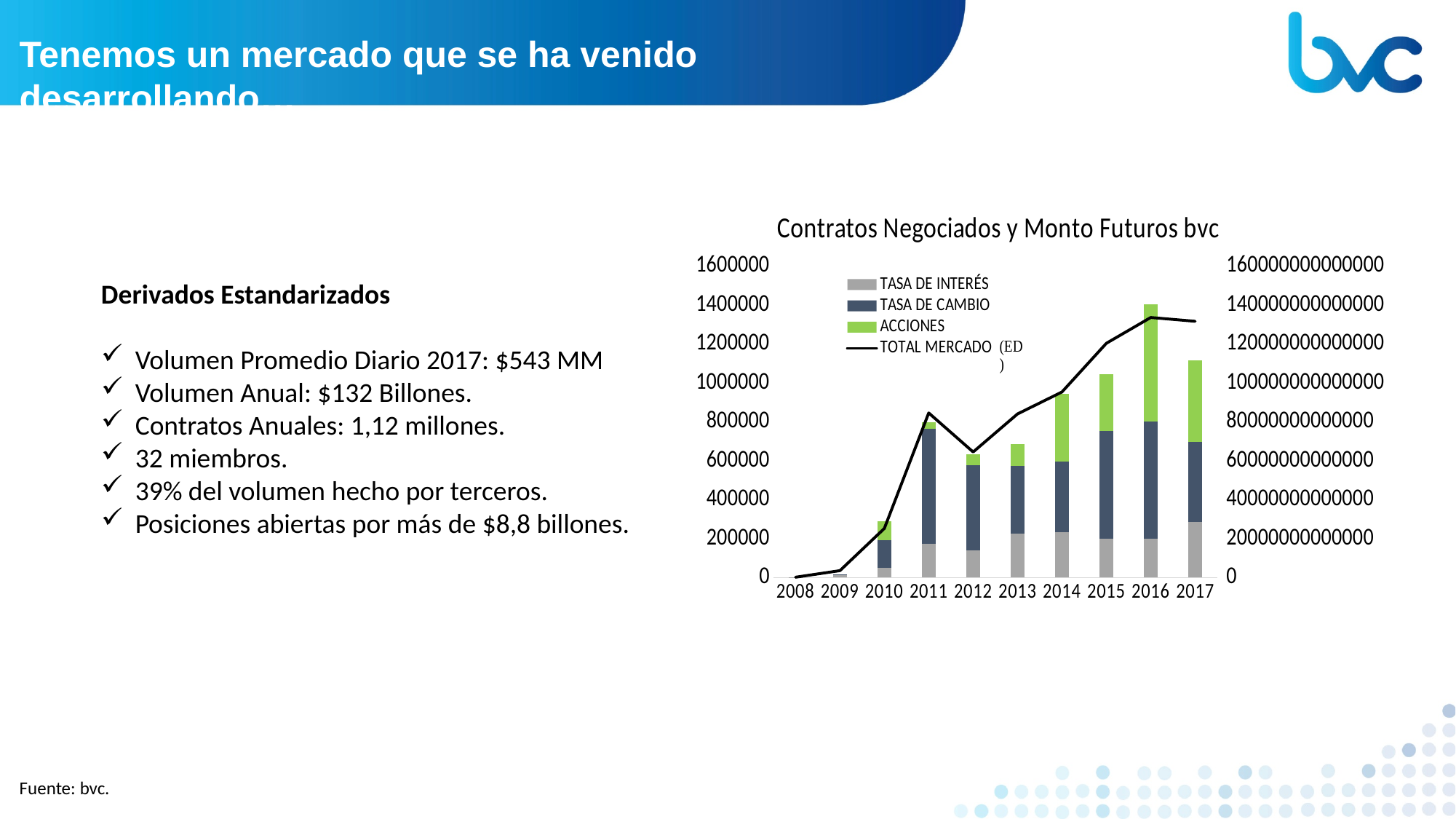
Is the total stacked bar for 2016 greater or less than 1200000? greater What kind of chart is shown on the slide? Stacked bar chart with a line Which colour represents ACCIONES in the chart? Green Is the total stacked bar for 2013 greater or less than 800000? less Which year has the taller stacked bar, 2016 or 2017? 2016 Which year has the smallest stacked bar? 2008 What is the title of the chart? Contratos Negociados y Monto Futuros bvc How many series does the chart legend list? 4 Is the total stacked bar for 2017 greater or less than 1000000? greater Which year has the taller stacked bar, 2010 or 2011? 2011 How many years are shown on the x axis of the chart? 10 Which year has the tallest stacked bar? 2016